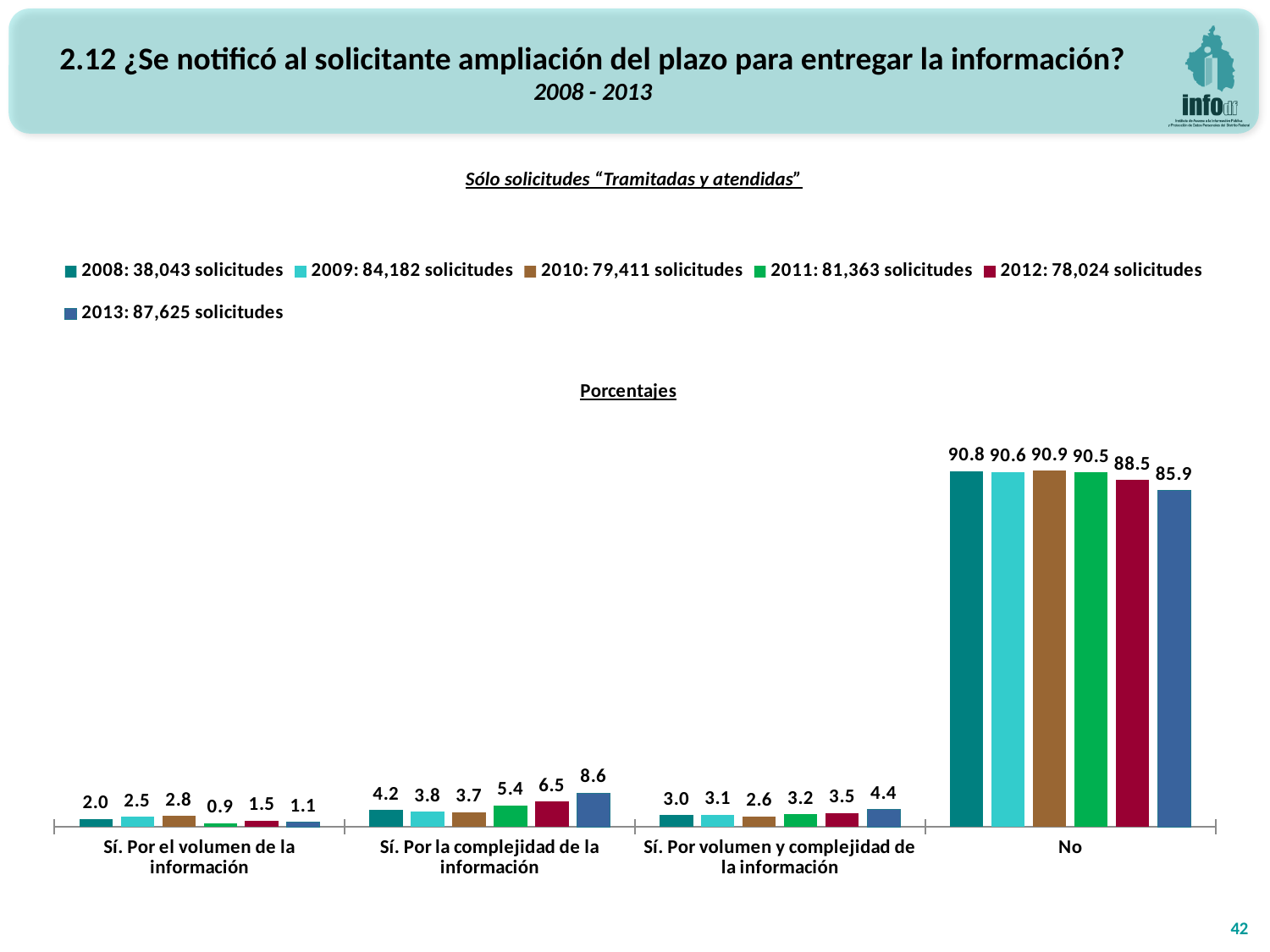
What is the value for 2013 in the "Sí. Por la complejidad de la información" category? 8.6 What is the value for 2008 in the "No" category? 90.8 Which year has the lowest value in the "No" category? 2013 How many series does the legend list? 6 How many categories are shown on the x axis of the chart? 4 According to the legend, how many solicitudes were there in 2013? 87,625 solicitudes What kind of chart is shown on the slide? bar chart Which year has the highest value in the "Sí. Por la complejidad de la información" category? 2013 What is the value for 2012 in the "Sí. Por volumen y complejidad de la información" category? 3.5 Which is larger in the "Sí. Por volumen y complejidad de la información" category: the value for 2013 or the value for 2010? 2013 What is the value for 2011 in the "Sí. Por el volumen de la información" category? 0.9 What is the difference between the 2008 and 2013 values in the "No" category? 4.9